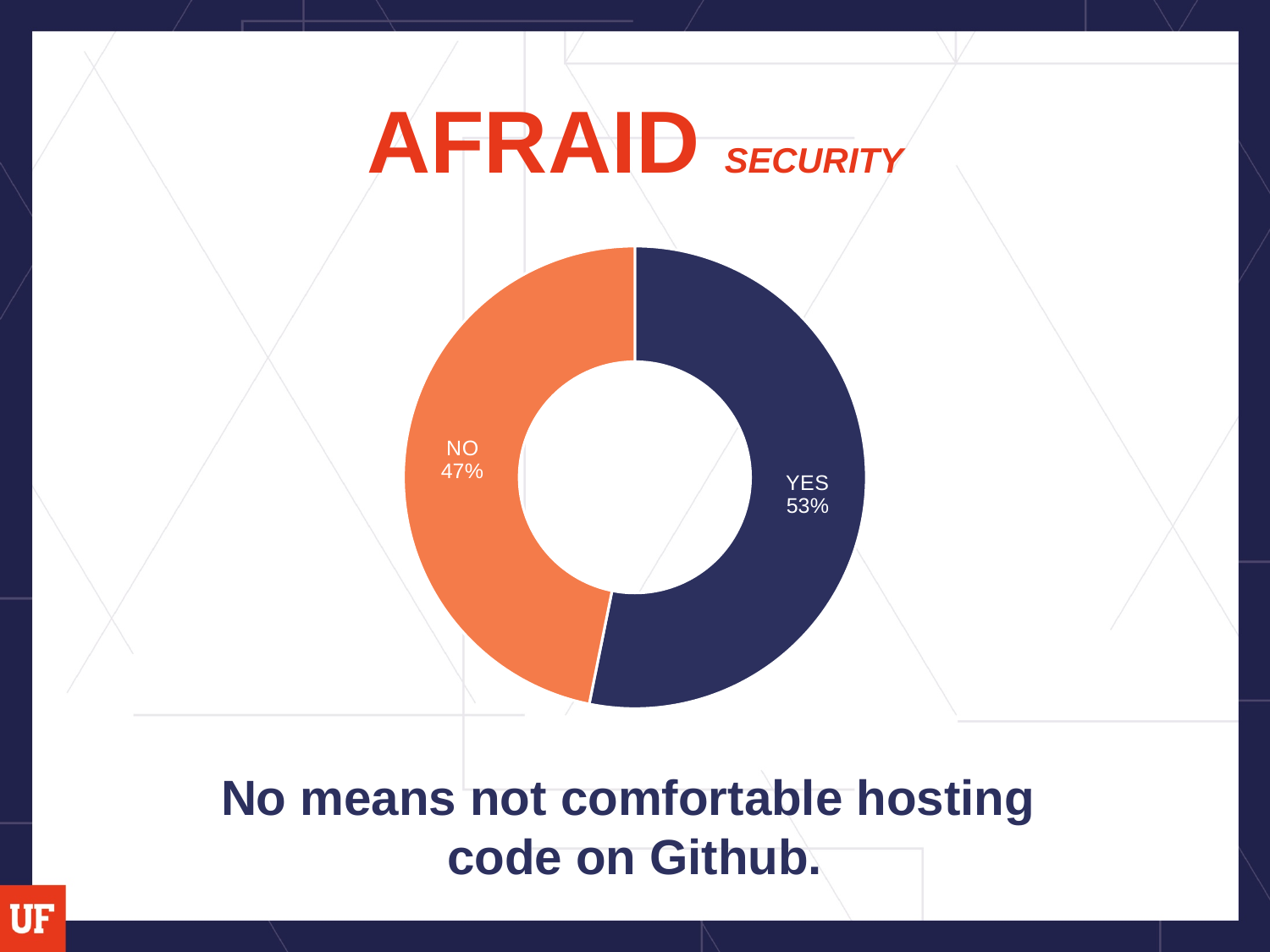
Which slice of the pie chart is the largest? YES Which slice of the pie chart is the smallest? NO What percentage of the pie chart is labelled YES? 53% What kind of chart is shown on the slide? Doughnut chart Which slice is larger, YES or NO? YES What share of the pie does the NO slice represent? 47% What percentage of the pie chart is labelled NO? 47% What is the difference in percentage points between the YES and NO slices? 6 What colour is the NO slice of the pie chart? Orange How many slices does the pie chart have? 2 What colour is the YES slice of the pie chart? Dark blue